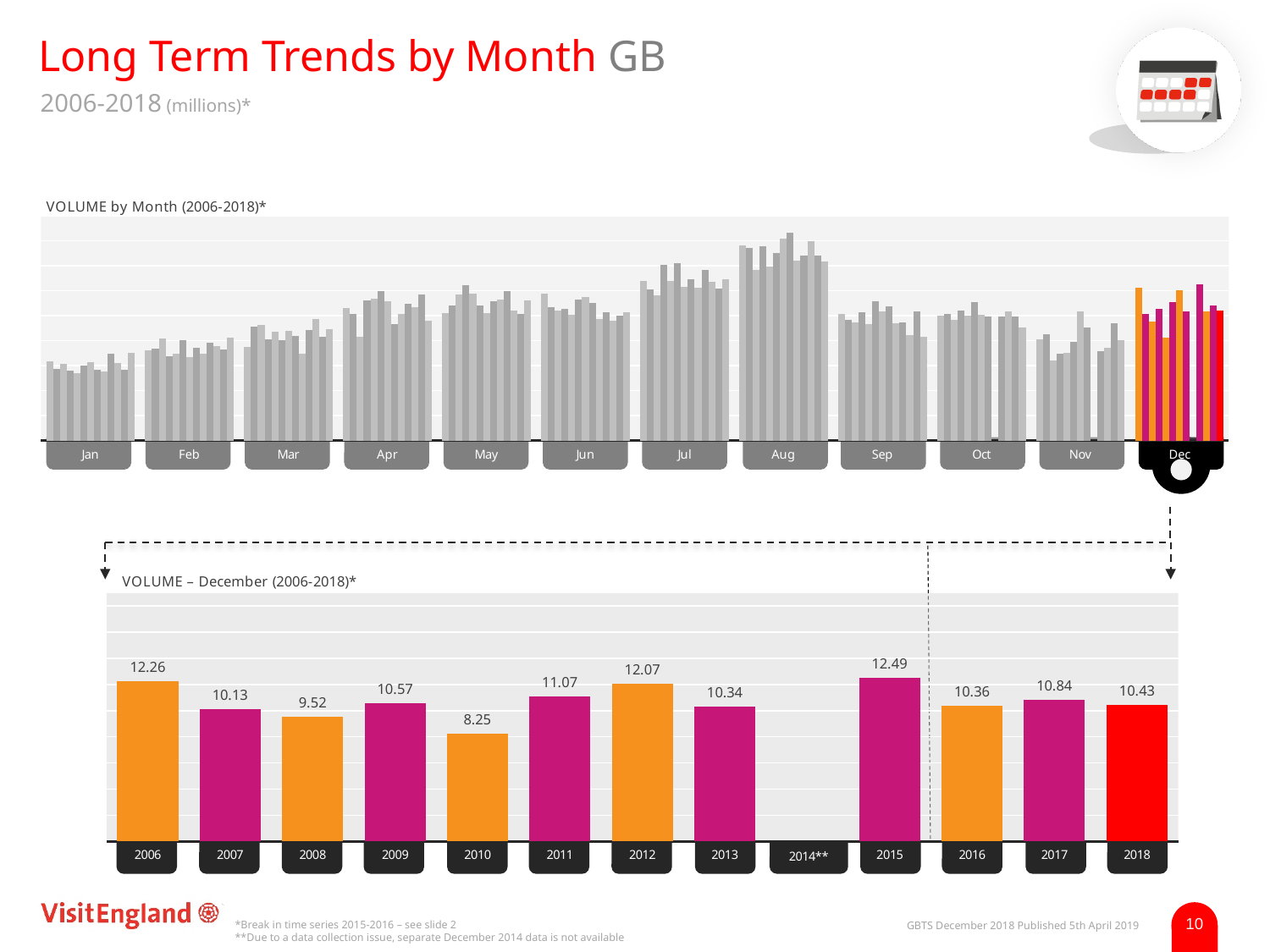
In the 'VOLUME by Month (2006-2018)' chart, how many months are shown along the x axis? 12 In the 'VOLUME – December (2006-2018)' chart, how many years have a value printed on the chart? 12 What kind of chart is the 'VOLUME by Month (2006-2018)' chart at the top of the slide? bar chart In the 'VOLUME – December (2006-2018)' chart, what is the value for 2006? 12.26 In the 'VOLUME – December (2006-2018)' chart, which year has the lowest value? 2010 In the 'VOLUME by Month (2006-2018)' chart, which month has the tallest bars? Aug In the 'VOLUME – December (2006-2018)' chart, what is the difference between the values for 2017 and 2018? 0.41 In the 'VOLUME – December (2006-2018)' chart, which year has no data shown? 2014 In the 'VOLUME – December (2006-2018)' chart, which year has the highest value? 2015 In the 'VOLUME – December (2006-2018)' chart, which is larger, the value for 2011 or the value for 2013? 2011 In the 'VOLUME – December (2006-2018)' chart, what is the value for 2018? 10.43 In the 'VOLUME – December (2006-2018)' chart, what is the value for 2010? 8.25